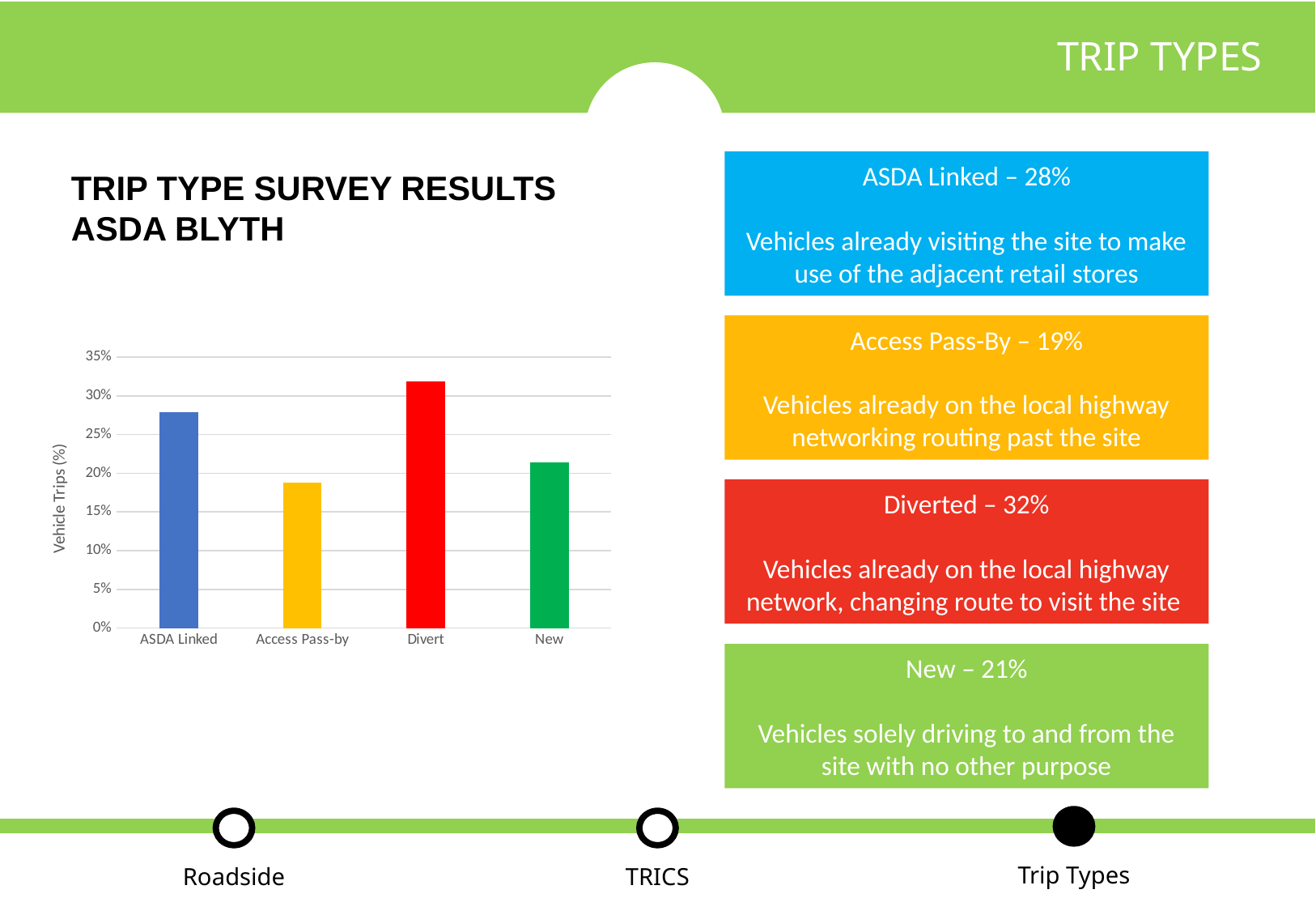
What percentage of vehicle trips are Diverted? 32% Is the value for New greater or less than 25%? less Is the value for Divert greater or less than 30%? greater What percentage of vehicle trips are ASDA Linked? 28% Which trip type has the highest share of vehicle trips? Divert What is the label on the vertical axis of the chart? Vehicle Trips (%) What kind of chart is shown on the slide? bar chart How many trip type categories are plotted on the chart? 4 What is the difference between the Diverted share and the Access Pass-By share? 13% Is the value for Access Pass-by greater or less than 20%? less Which is larger, the value for ASDA Linked or the value for New? ASDA Linked Which trip type has the lowest share of vehicle trips? Access Pass-by